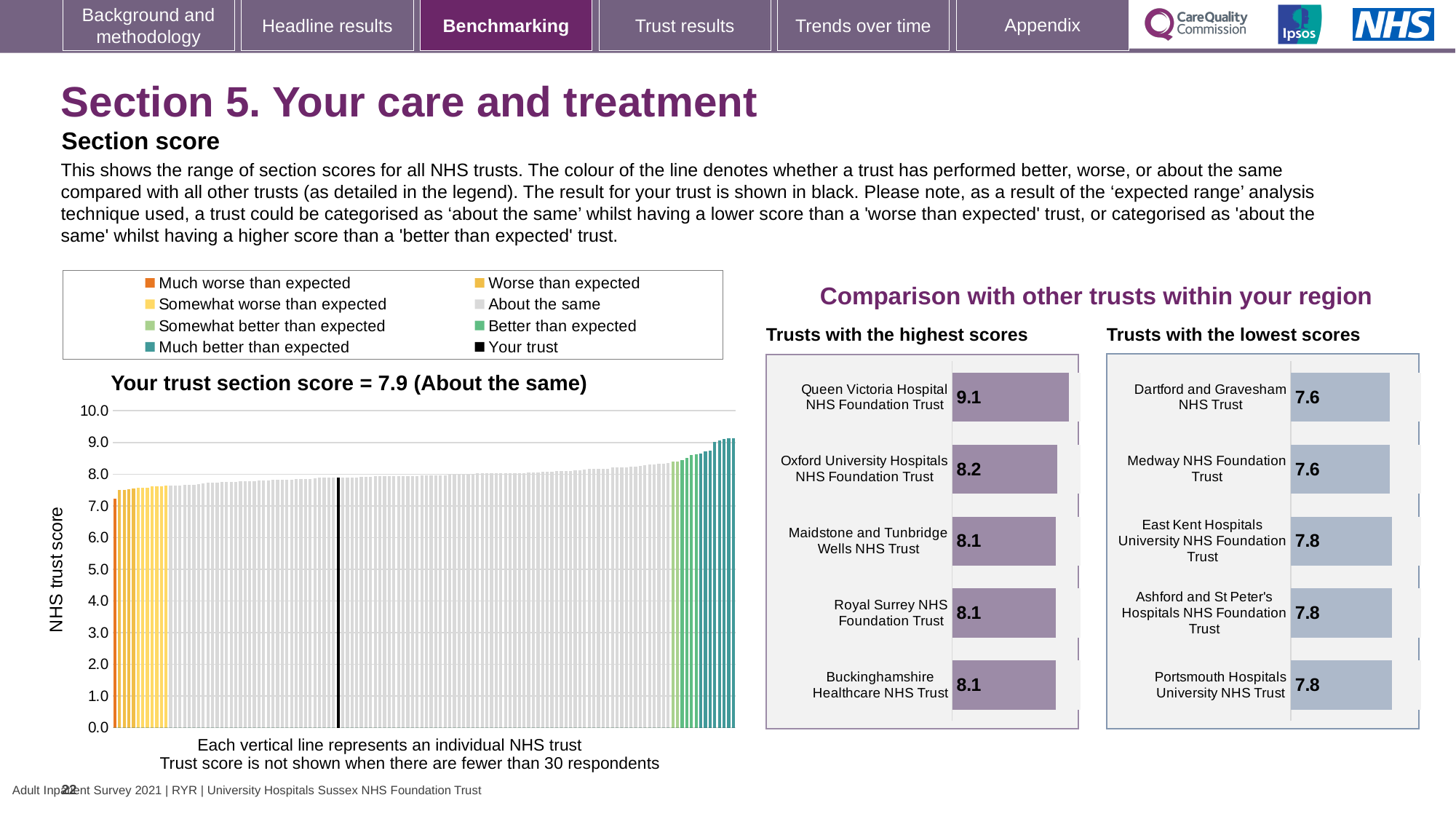
On the 'Trusts with the lowest scores' chart, what is the score for Medway NHS Foundation Trust? 7.6 How many trusts are shown on the 'Trusts with the highest scores' chart? 5 On the 'Your trust section score' chart, is the value for the lowest-scoring trust greater or less than 8.0? less On the 'Your trust section score' chart, what is the label on the vertical axis? NHS trust score On the 'Your trust section score' chart, what kind of chart is shown? bar chart How many entries does the legend above the 'Your trust section score' chart list? 8 On the 'Trusts with the lowest scores' chart, which has the larger score: East Kent Hospitals University NHS Foundation Trust or Dartford and Gravesham NHS Trust? East Kent Hospitals University NHS Foundation Trust On the 'Trusts with the highest scores' chart, which trust has the highest score? Queen Victoria Hospital NHS Foundation Trust On the 'Trusts with the highest scores' chart, what is the score for Queen Victoria Hospital NHS Foundation Trust? 9.1 On the 'Trusts with the lowest scores' chart, what is the difference between the scores of Portsmouth Hospitals University NHS Trust and Dartford and Gravesham NHS Trust? 0.2 On the 'Trusts with the highest scores' chart, what is the difference between the scores of Queen Victoria Hospital NHS Foundation Trust and Oxford University Hospitals NHS Foundation Trust? 0.9 On the 'Your trust section score' chart, what is the section score for your trust? 7.9